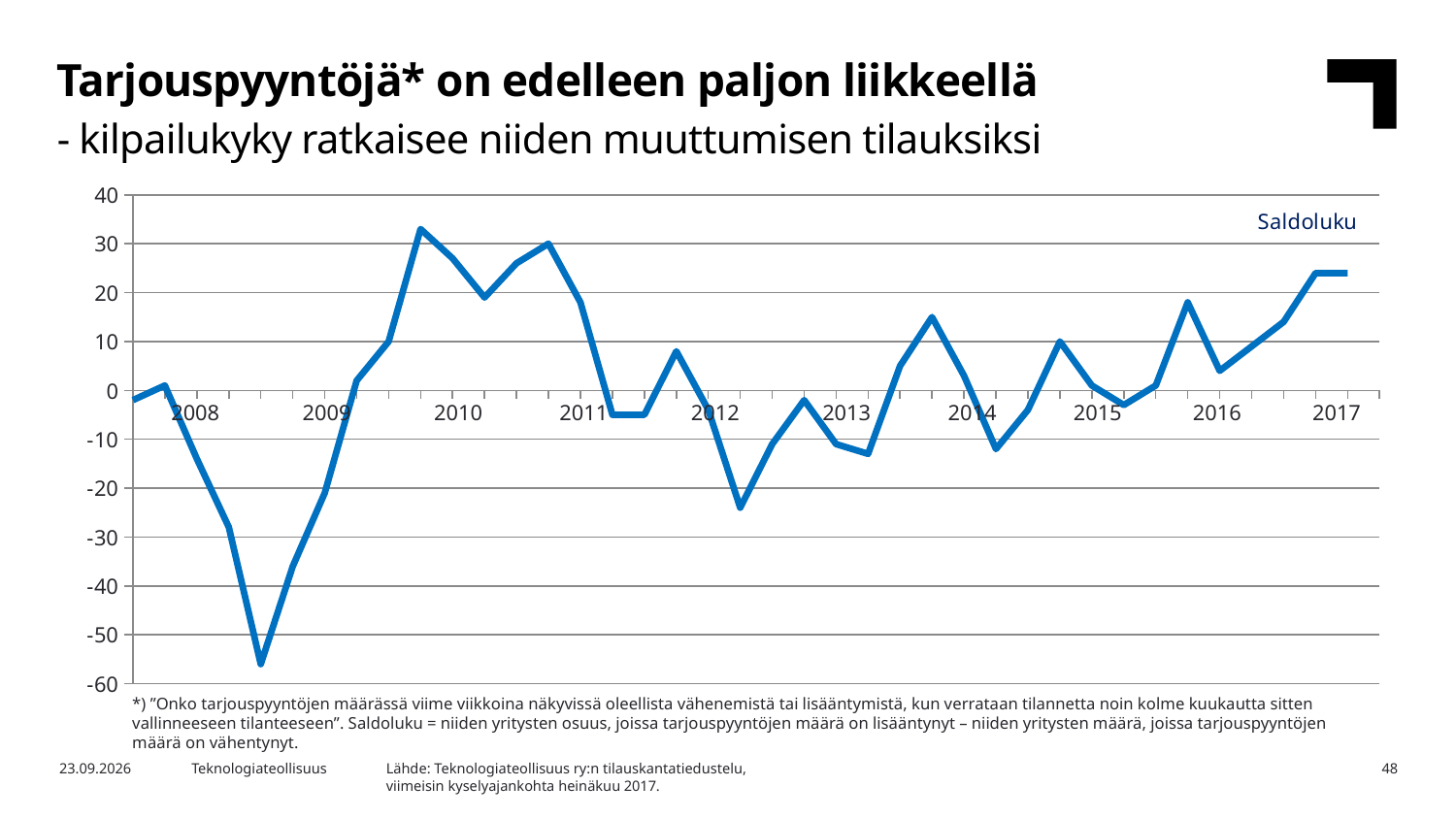
Is the value at the end of the line in 2017 greater or less than 20? greater What is the highest value shown on the vertical axis? 40 Is the lowest point of the line greater or less than -50? less Does the line rise or fall between 2011 and 2012? fall Is the highest point of the line greater or less than 30? greater How many series does the legend list? 1 What kind of chart is shown on the slide? line chart How many year labels are shown on the x axis? 10 What is the name of the series shown in the legend? Saldoluku Does the line rise or fall between 2015 and 2017? rise